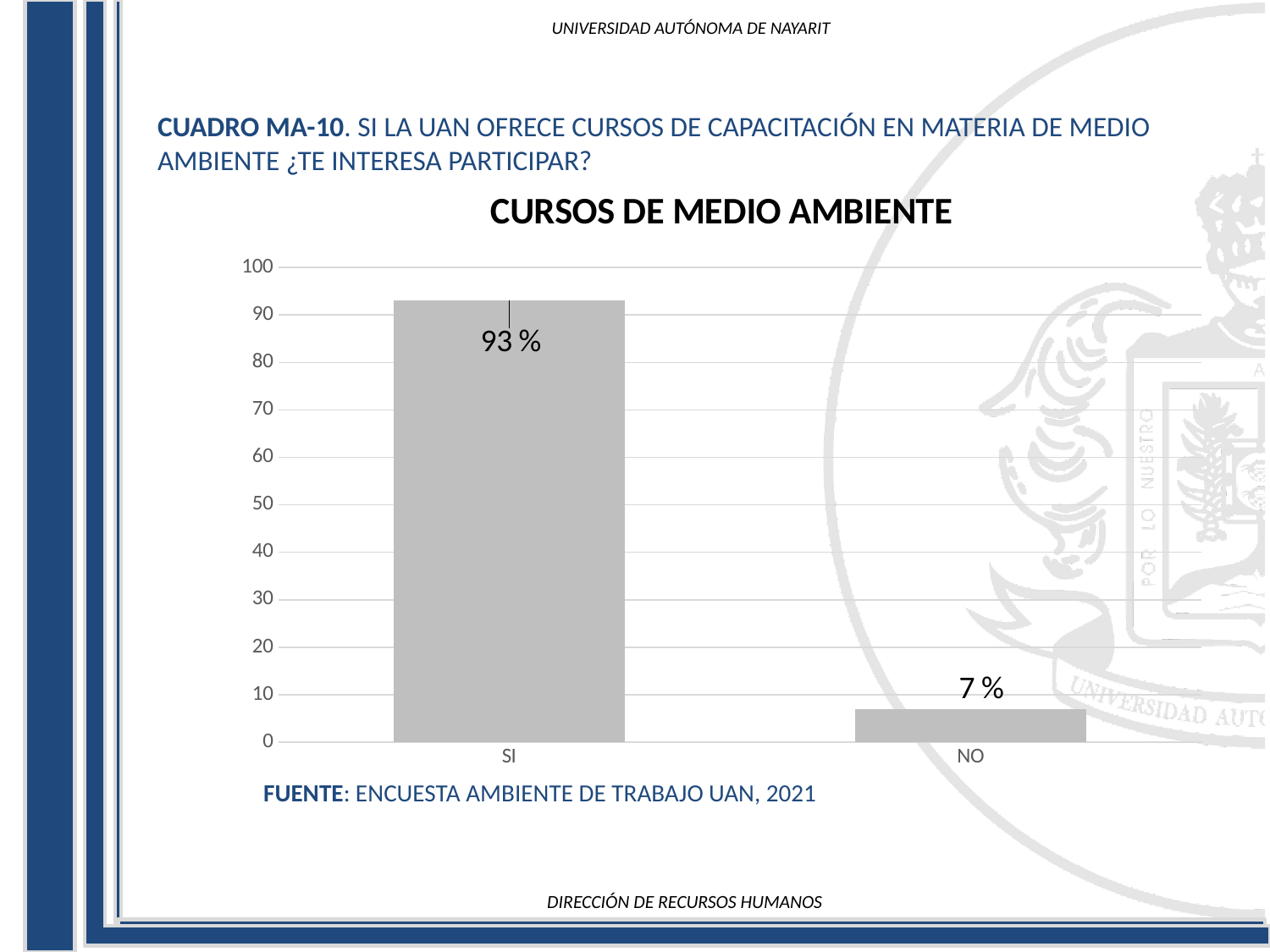
Is the value for SI greater or less than 90? greater Which is larger, the value for SI or the value for NO? SI Which category has the highest value? SI What is the difference between the values for SI and NO? 86 % What is the title of the chart? CURSOS DE MEDIO AMBIENTE What is the highest value shown on the y axis? 100 How many categories are shown on the x axis? 2 What is the value for NO in the chart? 7 % What kind of chart is shown on the slide? bar chart Is the value for NO greater or less than 10? less What is the value for SI in the chart? 93 % Which category has the lowest value? NO